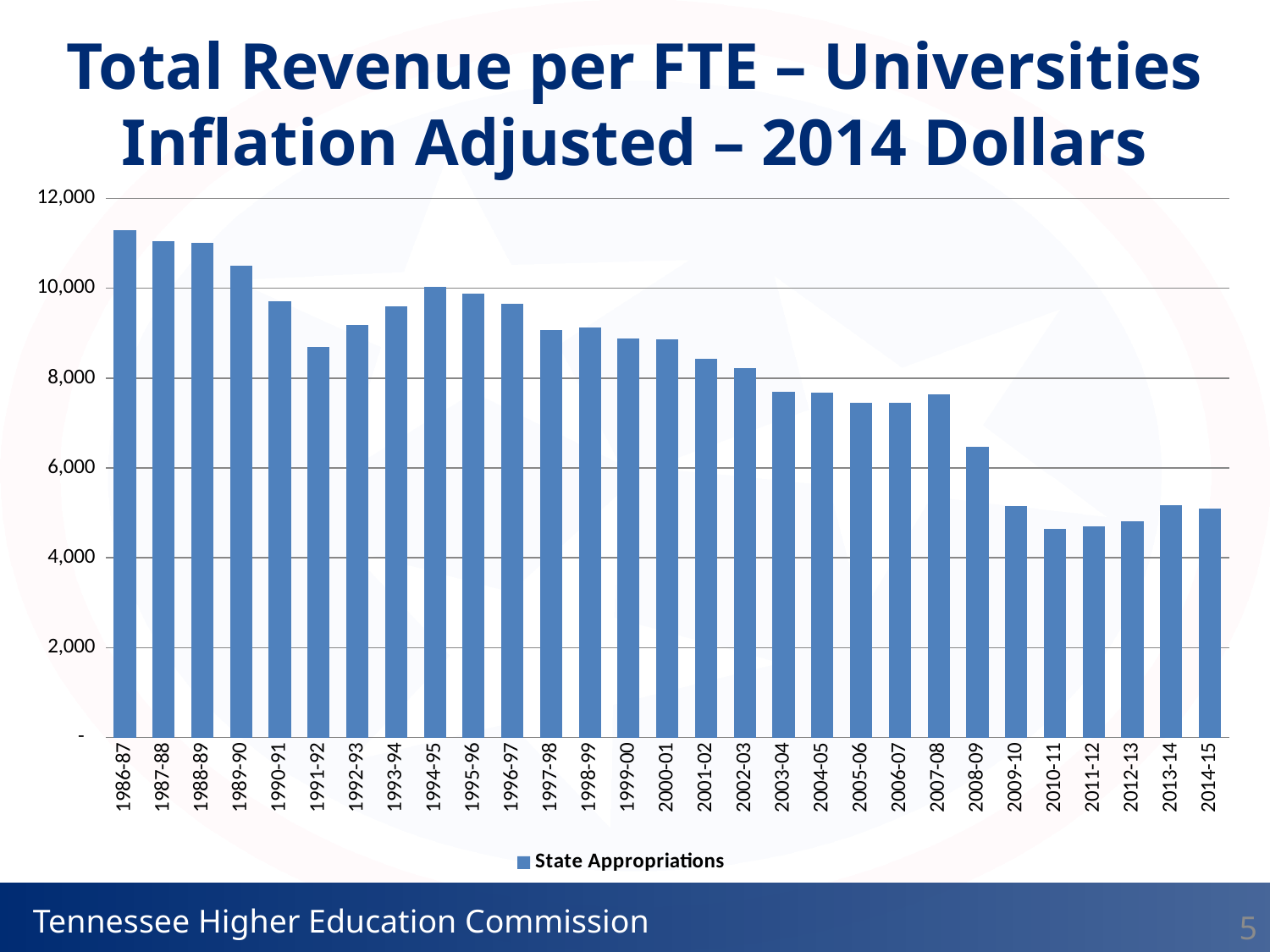
What is the name of the series shown in the legend? State Appropriations Which is larger, the value for 2008-09 or the value for 2009-10? 2008-09 Is the value for 2014-15 greater or less than 6,000? less Is the value for 2003-04 greater or less than 8,000? less How many academic years are plotted on the x axis? 29 Is the value for 2008-09 greater or less than 6,000? greater Which academic year has the highest value? 1986-87 How many series does the legend list? 1 What kind of chart is shown on the slide? bar chart Which is larger, the value for 1994-95 or the value for 1991-92? 1994-95 Do the values generally rise or fall from 1986-87 to 2014-15? fall